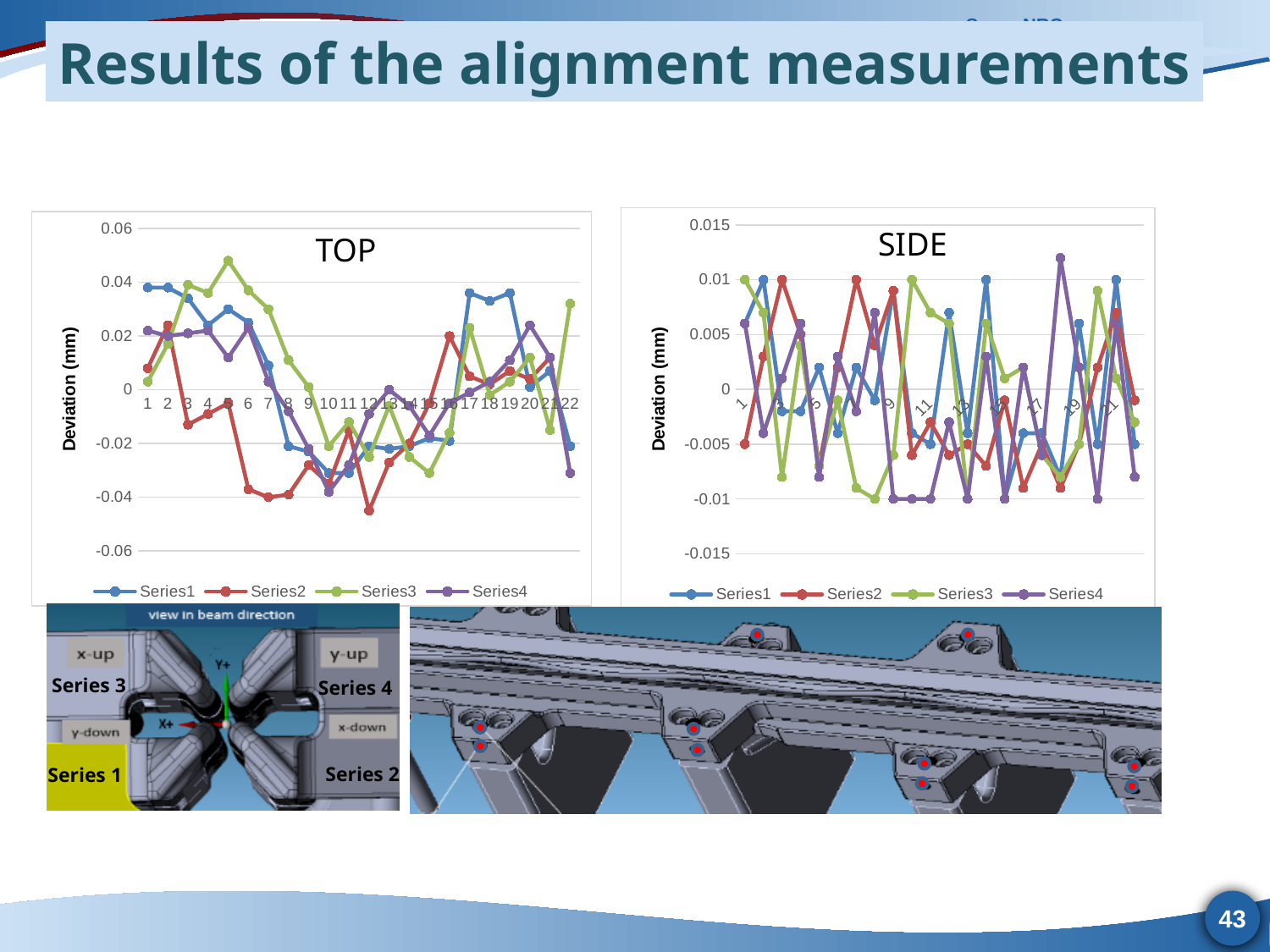
In the TOP chart, is the value of Series2 at point 11 greater or less than -0.04? greater What is the highest value shown on the y axis of the SIDE chart? 0.015 How many series does the legend of the SIDE chart list? 4 How many series does the legend of the TOP chart list? 4 In the TOP chart, which series reaches the highest value? Series3 In the TOP chart, is the value of Series4 at point 22 greater or less than -0.02? less In the TOP chart, which series reaches the lowest value? Series2 What is the y-axis label of the SIDE chart? Deviation (mm) How many points are plotted along the x axis of the TOP chart? 22 In the TOP chart, is the value of Series3 at point 5 greater or less than 0.04? greater What kind of chart is the TOP chart? line chart